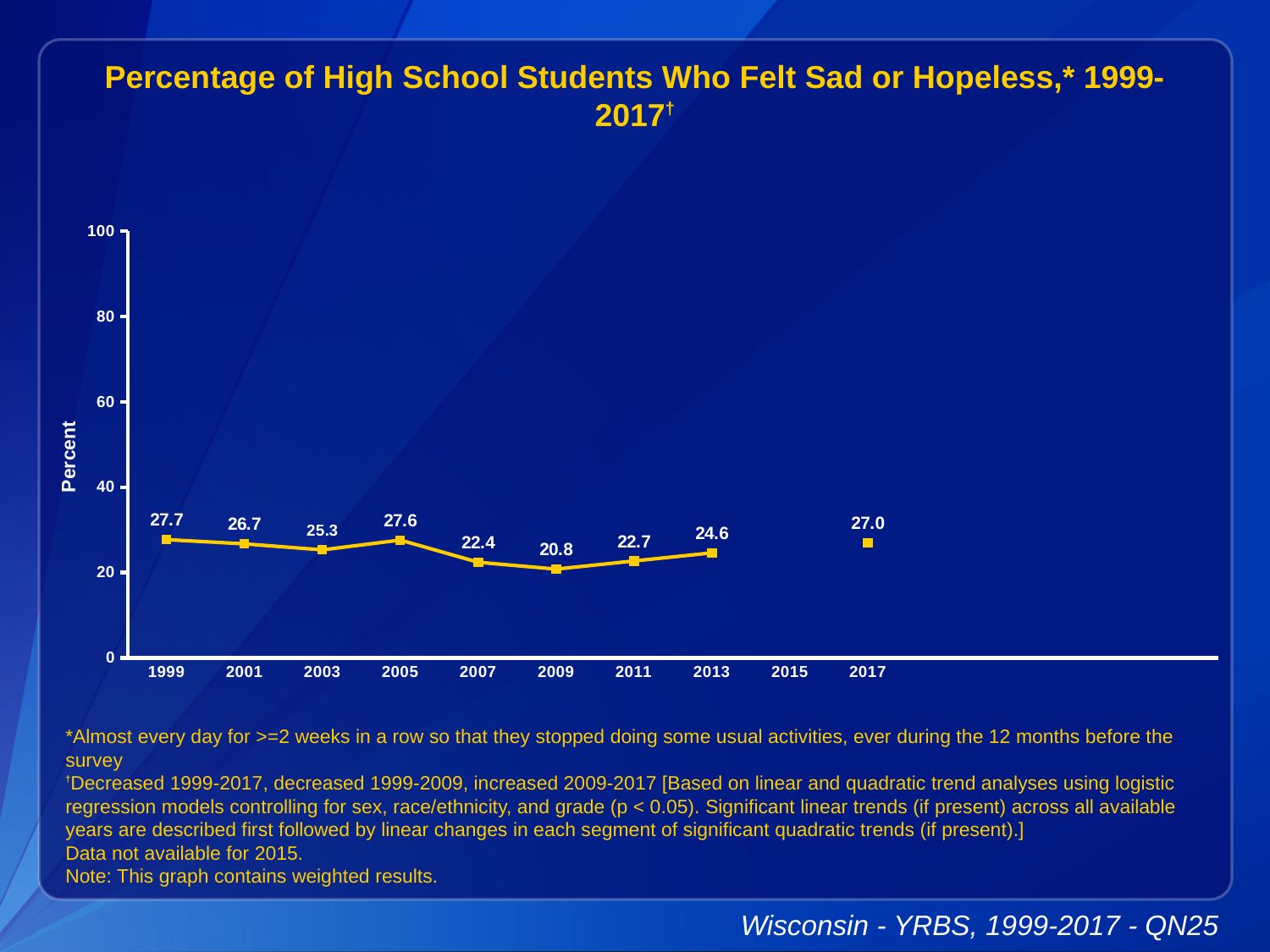
What is the value plotted for 2009? 20.8 Which year has the lowest percentage of students who felt sad or hopeless? 2009 What is the difference between the 1999 value and the 2009 value? 6.9 What is the value plotted for 2017? 27.0 Which year has a larger value, 2005 or 2013? 2005 What is the label on the y axis? Percent Is the value for 2011 greater or less than 40? less Did the percentage rise or fall from 1999 to 2009? fall Which year has the highest percentage of students who felt sad or hopeless? 1999 What percentage of high school students felt sad or hopeless in 1999? 27.7 How many years have a data point plotted on the chart? 9 What kind of chart is shown on the slide? line chart